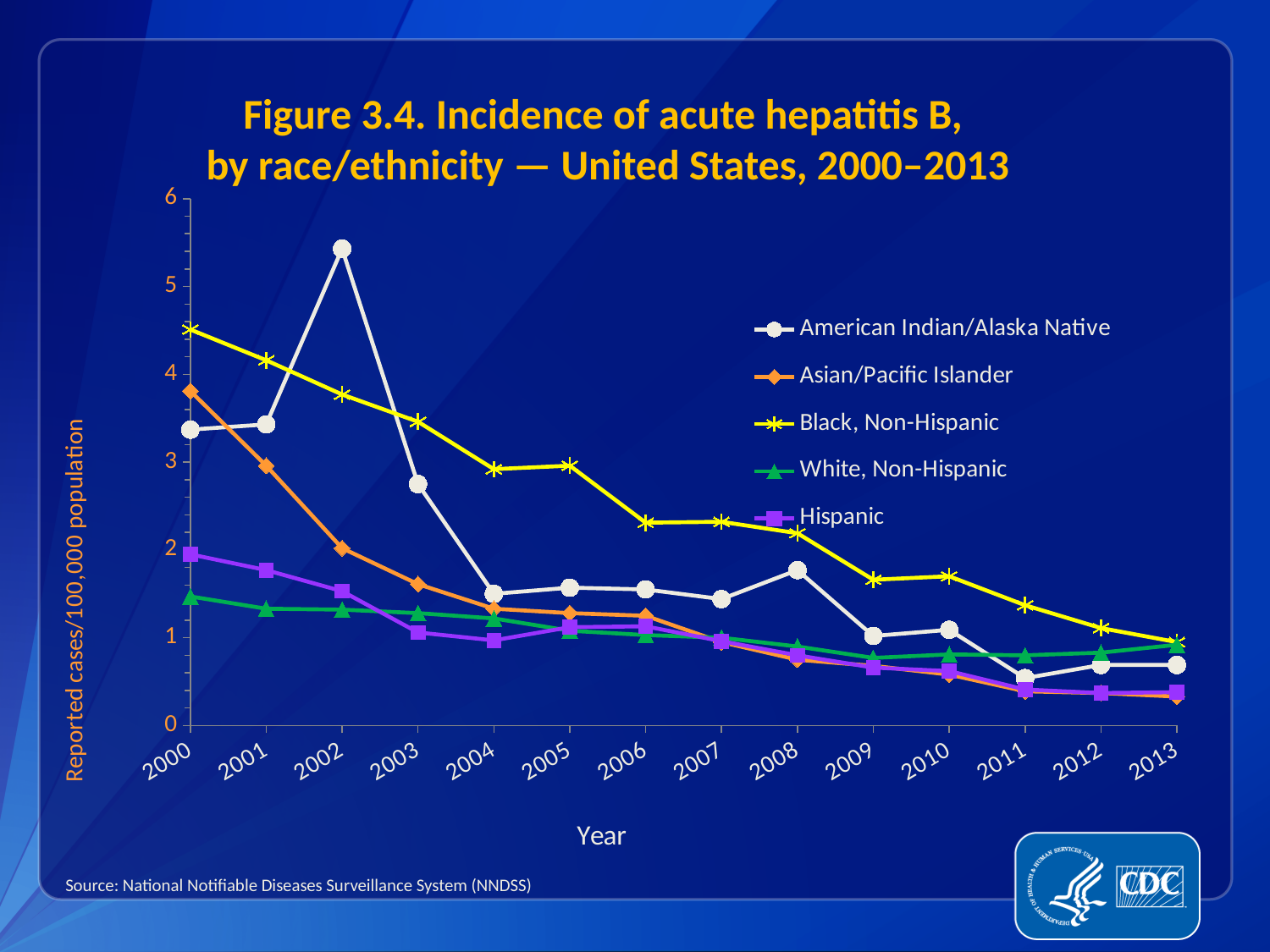
Which race/ethnicity group had the highest incidence in 2000? Black, Non-Hispanic What is the label of the y axis? Reported cases/100,000 population How many years are plotted along the x axis? 14 What kind of chart is shown on the slide? line chart Is the value for Asian/Pacific Islander in 2013 greater or less than 1? less Which group shows the highest single value on the chart, in 2002? American Indian/Alaska Native Does the incidence for Black, Non-Hispanic generally rise or fall from 2000 to 2013? fall Is the value for Black, Non-Hispanic in 2000 greater or less than 4? greater Is the value for American Indian/Alaska Native in 2002 greater or less than 5? greater In 2000, which is larger: the value for Asian/Pacific Islander or the value for Hispanic? Asian/Pacific Islander How many series does the legend list? 5 Which race/ethnicity group had the lowest incidence in 2000? White, Non-Hispanic